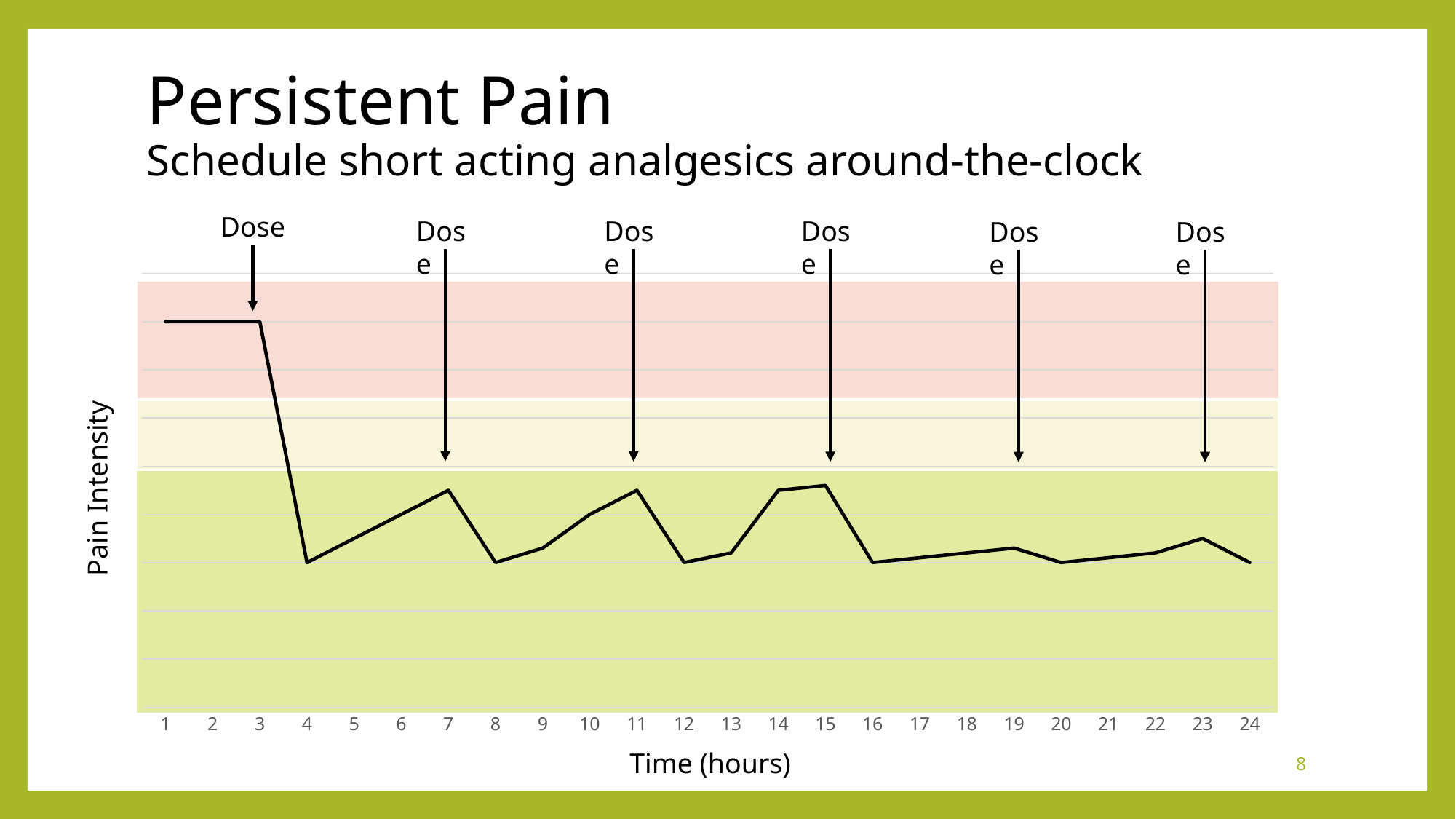
Which has the higher pain intensity, hour 1 or hour 24? hour 1 Does pain intensity rise or fall between hour 4 and hour 7? rise What kind of chart is shown on the slide? line chart Which has the higher pain intensity, hour 7 or hour 8? hour 7 Does pain intensity rise or fall between hour 3 and hour 4? fall Which has the higher pain intensity, hour 11 or hour 12? hour 11 How many data series are plotted on the chart? 1 What is the label of the x axis? Time (hours) Does pain intensity rise or fall between hour 15 and hour 16? fall How many time points are plotted along the x axis? 24 How many "Dose" arrows are marked above the chart? 6